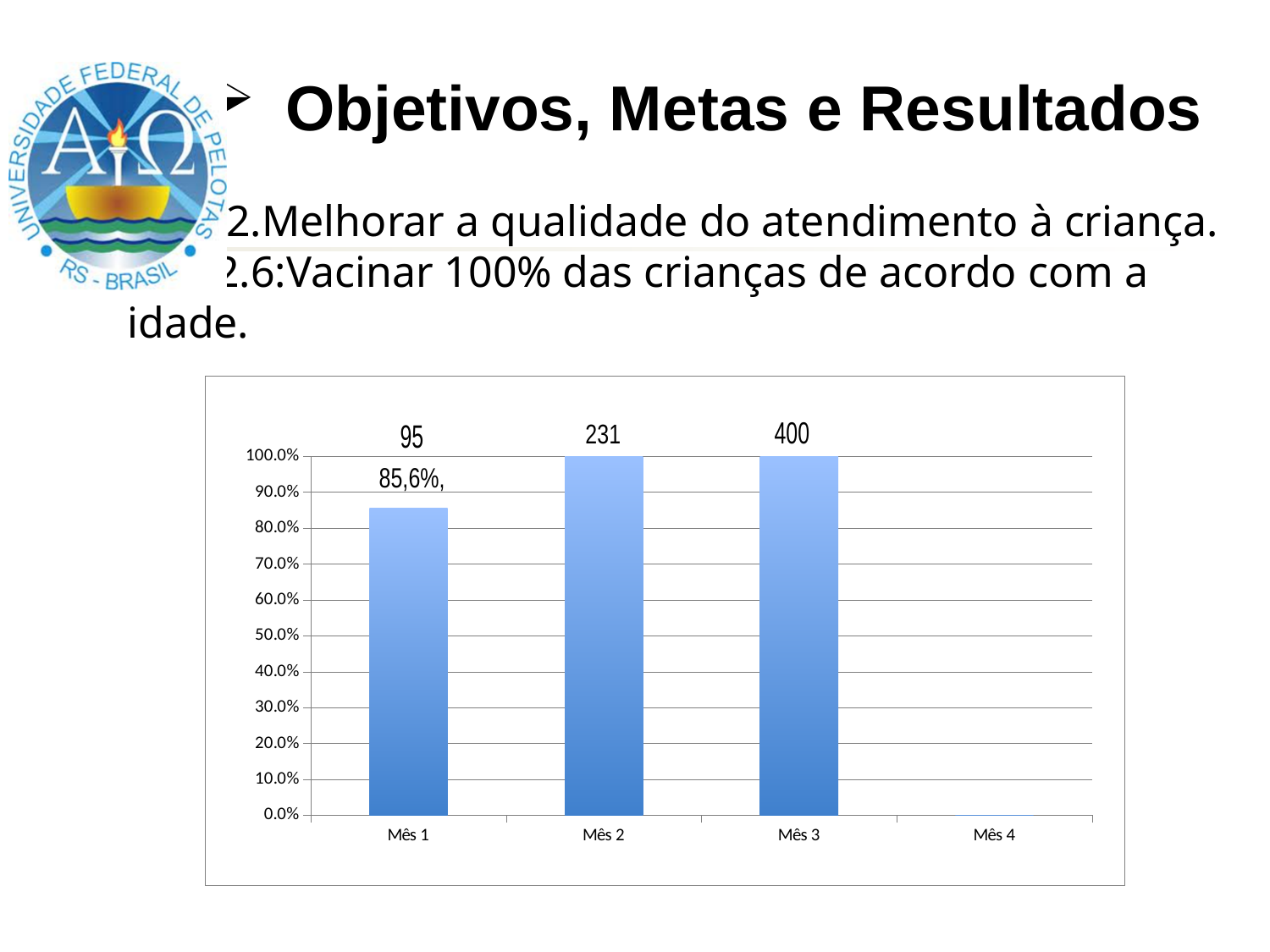
What number is printed above the bar for Mês 3? 400 What kind of chart is shown on the slide? bar chart How many categories are shown on the x axis of the chart? 4 Which category on the x axis has no bar plotted? Mês 4 What percentage is printed as the data label for Mês 1? 85,6% What value does the bar for Mês 2 reach on the y axis? 100.0% Which category has the lowest bar among those with a visible bar? Mês 1 Is the value for Mês 1 greater or less than 80.0%? greater What value does the bar for Mês 3 reach on the y axis? 100.0% Is the value for Mês 1 greater or less than 90.0%? less What number is printed above the bar for Mês 2? 231 Which is larger, the bar for Mês 1 or the bar for Mês 2? Mês 2